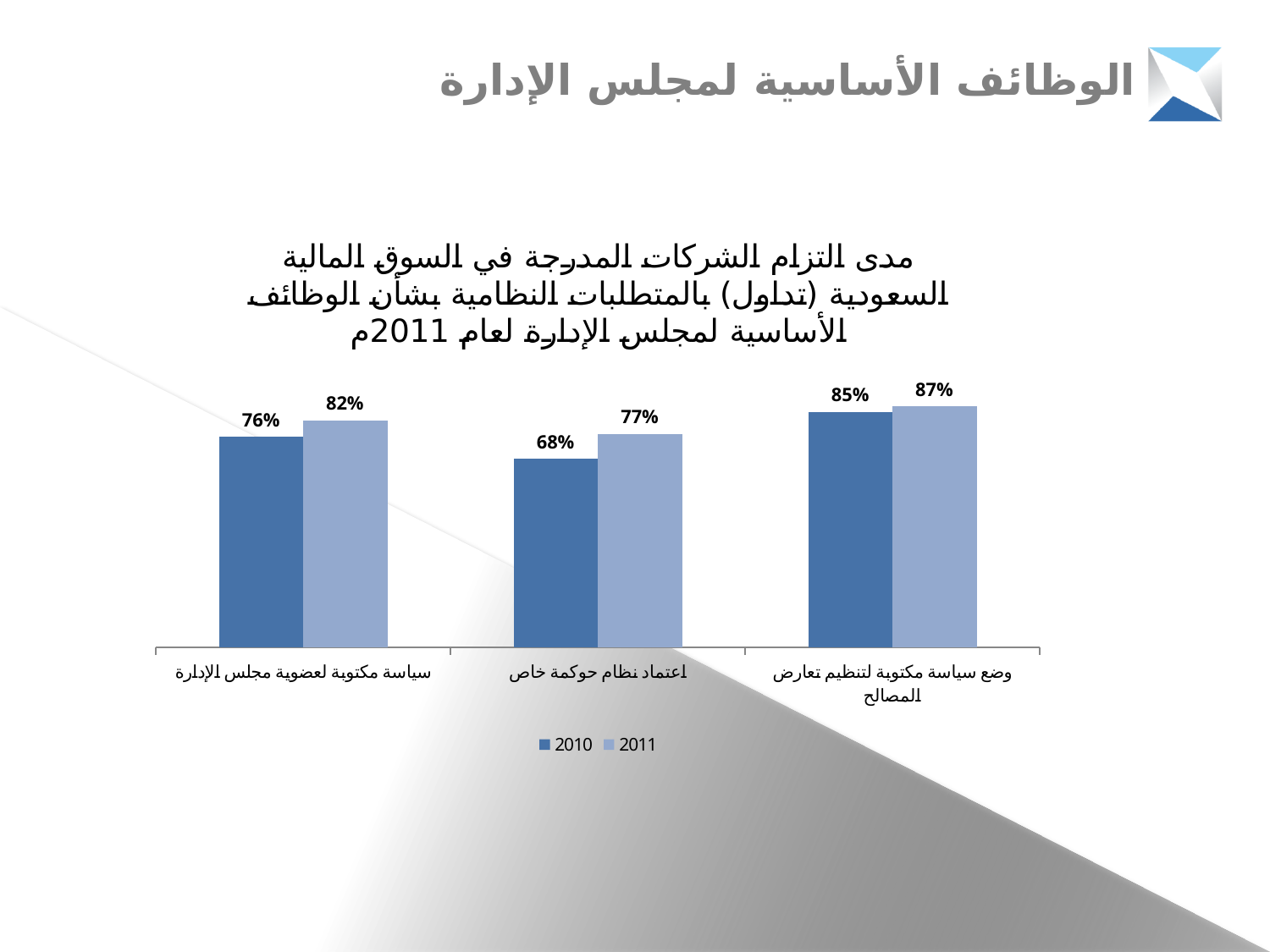
What is the difference between the 2011 and 2010 values for "سياسة مكتوبة لعضوية مجلس الإدارة"? 6% What is the 2011 value for "وضع سياسة مكتوبة لتنظيم تعارض المصالح"? 87% Which is larger: the 2010 value for "وضع سياسة مكتوبة لتنظيم تعارض المصالح" or the 2011 value for "سياسة مكتوبة لعضوية مجلس الإدارة"? 2010 value for وضع سياسة مكتوبة لتنظيم تعارض المصالح What is the 2010 value for "سياسة مكتوبة لعضوية مجلس الإدارة"? 76% Which series is shown in the darker blue colour? 2010 What kind of chart is shown on the slide? bar chart What is the difference between the 2011 and 2010 values for "اعتماد نظام حوكمة خاص"? 9% Which category has the highest 2010 value? وضع سياسة مكتوبة لتنظيم تعارض المصالح How many categories are shown on the x axis? 3 What is the 2011 value for "اعتماد نظام حوكمة خاص"? 77% How many series does the legend list? 2 Which category has the lowest 2011 value? اعتماد نظام حوكمة خاص